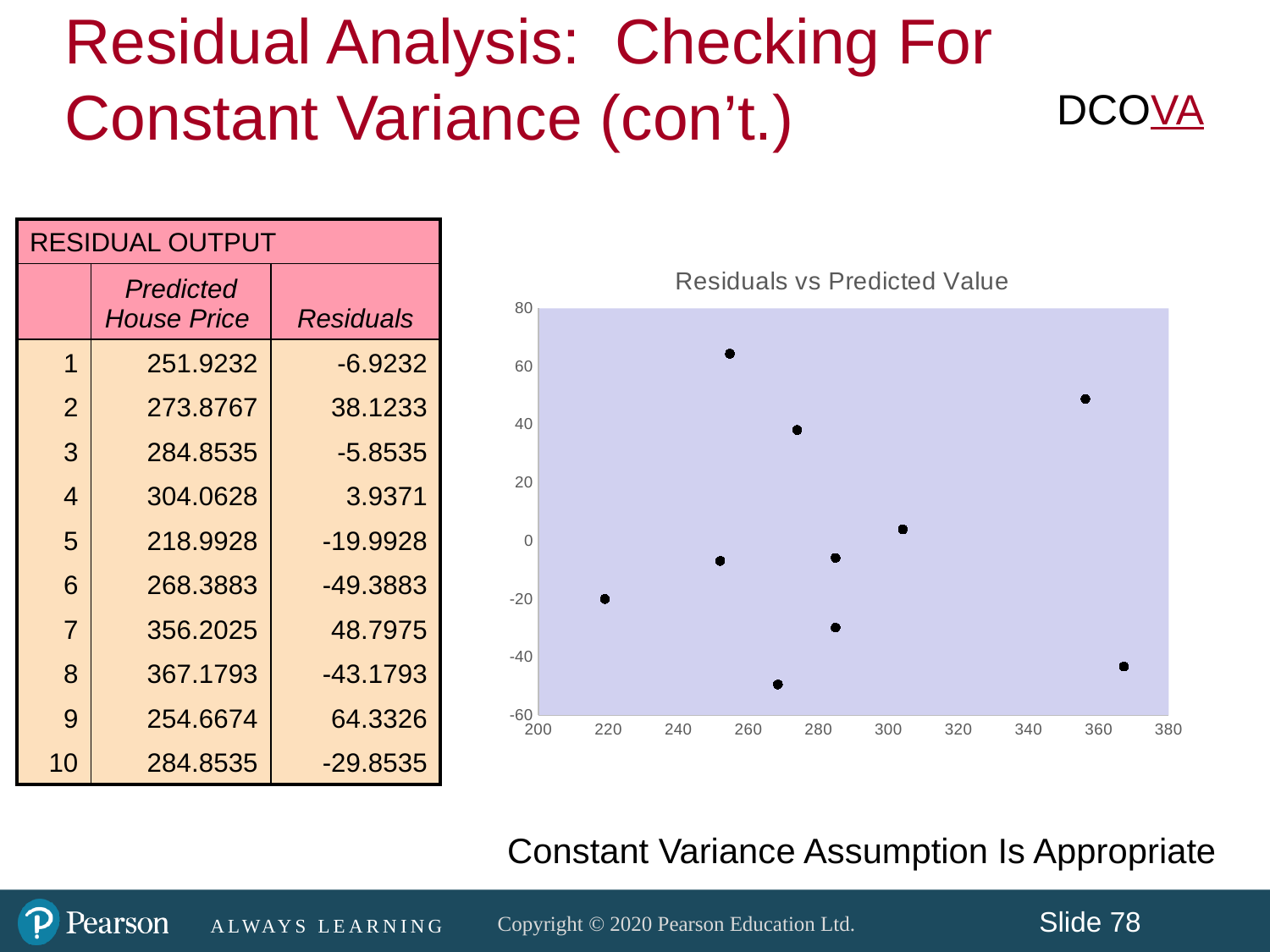
What is the title of the chart? Residuals vs Predicted Value How many data points are plotted in the Residuals vs Predicted Value chart? 10 What is the largest residual value shown in the residual output? 64.3326 What is the range of the x axis in the Residuals vs Predicted Value chart? 200 to 380 Is the residual for the point with a predicted value near 356 greater or less than 40? greater How many points in the chart have a residual less than 0? 6 Is the residual for the point with a predicted value near 254 greater or less than 60? greater How many points in the chart have a residual greater than 0? 4 Is the residual for the point with a predicted value near 268 greater or less than -40? less Do the residuals show a clear rising or falling trend as the predicted value increases? no clear trend What kind of chart is shown on the slide? scatter chart